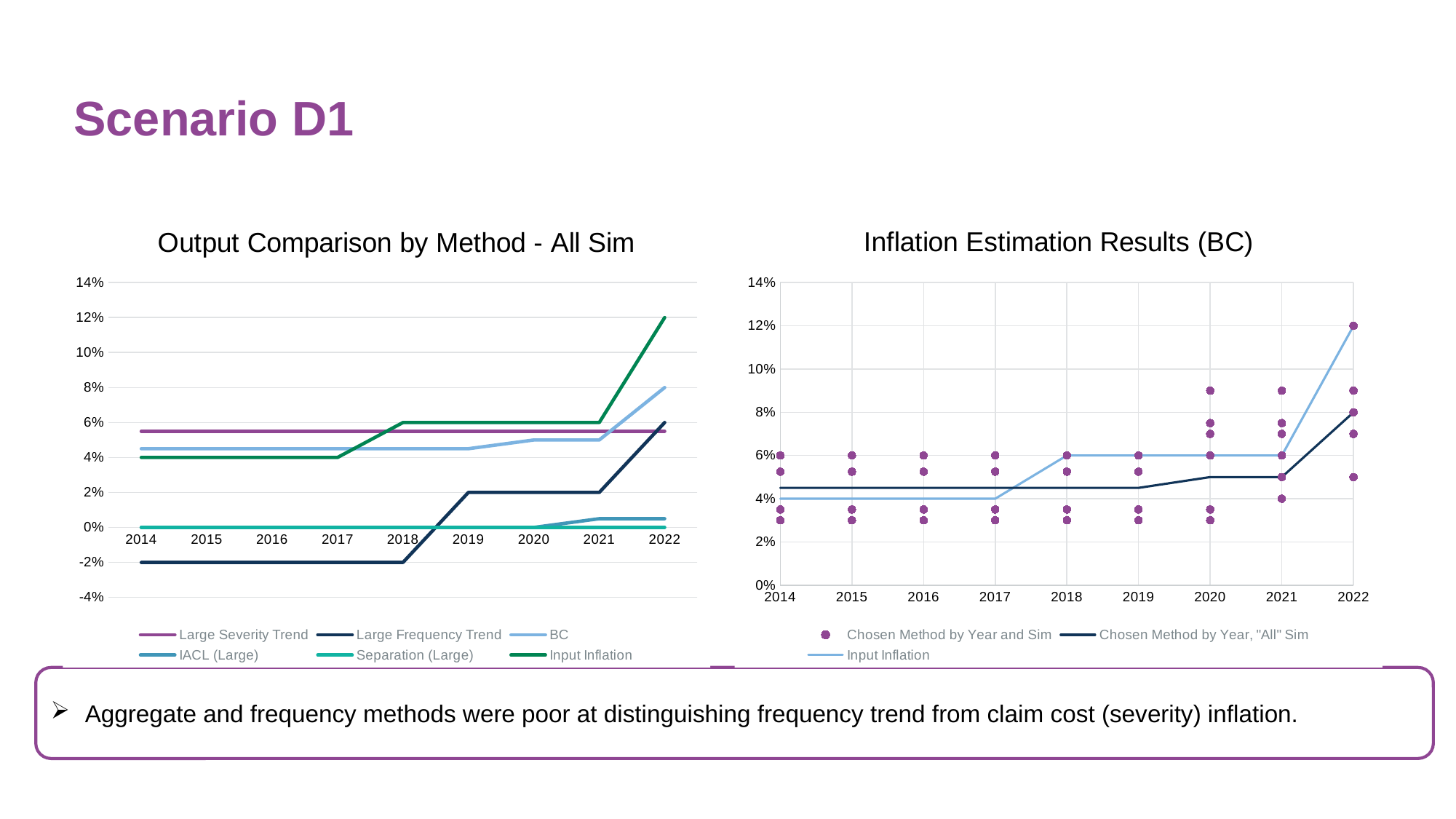
In "Output Comparison by Method - All Sim", is the Large Severity Trend value in 2014 greater or less than 4%? greater In "Inflation Estimation Results (BC)", is the Chosen Method by Year, "All" Sim value in 2022 greater or less than 6%? greater In "Output Comparison by Method - All Sim", which series has the highest value in 2022? Input Inflation In "Output Comparison by Method - All Sim", what is the Large Frequency Trend value in 2014? -2% How many years are shown on the x axis of "Output Comparison by Method - All Sim"? 9 What kind of chart is "Output Comparison by Method - All Sim"? line chart In "Output Comparison by Method - All Sim", what is the Input Inflation value in 2022? 12% How many series does the legend of "Inflation Estimation Results (BC)" list? 3 In "Output Comparison by Method - All Sim", does the Large Frequency Trend series rise or fall from 2014 to 2022? rise How many series does the legend of "Output Comparison by Method - All Sim" list? 6 In "Output Comparison by Method - All Sim", what is the difference between the Input Inflation value in 2022 and in 2014? 8% In "Output Comparison by Method - All Sim", what is the Separation (Large) value in 2022? 0%